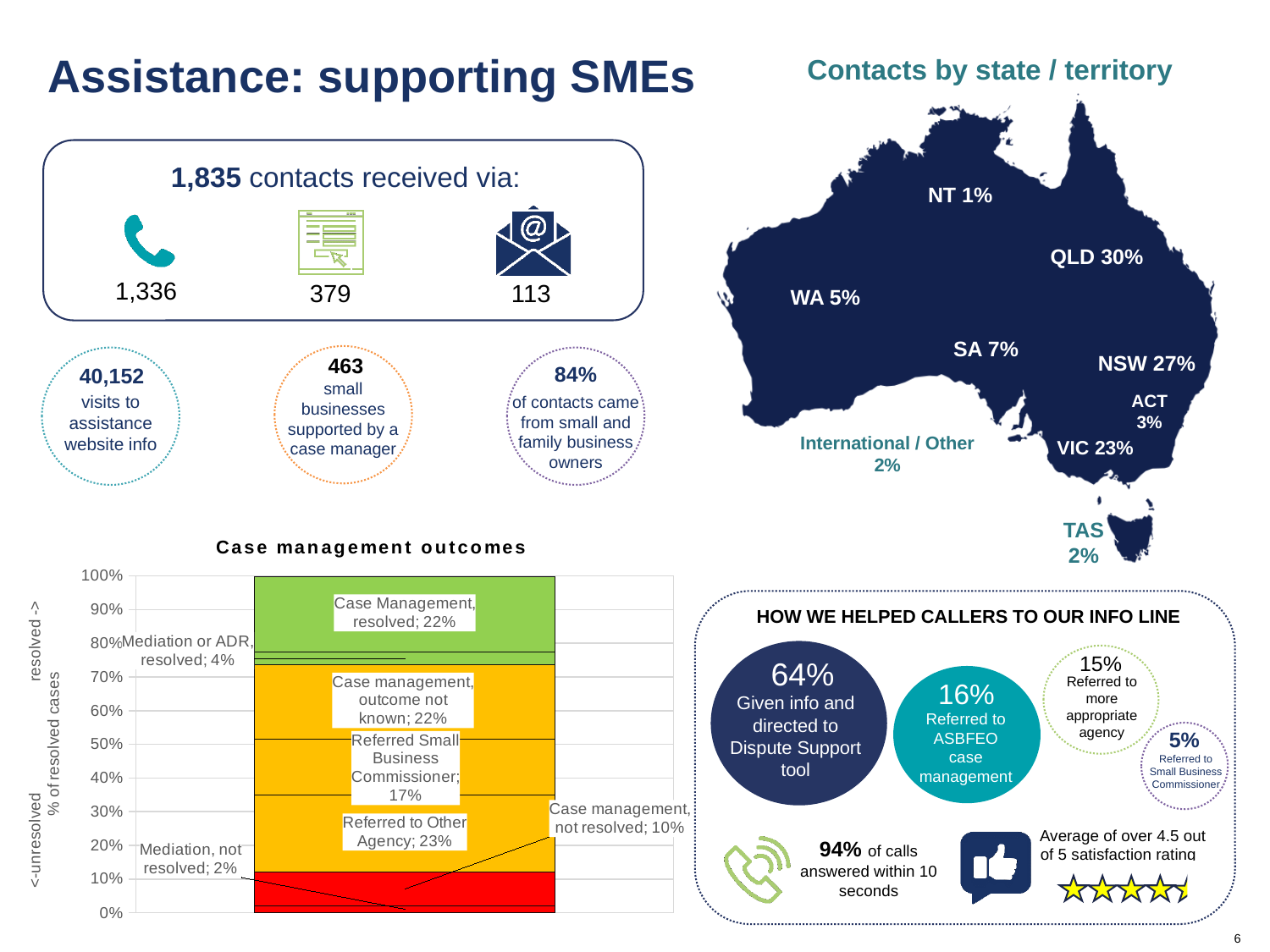
What is the total of all labelled segments in the 'Case management outcomes' stacked bar? 100% In the 'Case management outcomes' chart, what percentage is labelled for 'Referred to Other Agency'? 23% How many labelled segments make up the stacked bar in the 'Case management outcomes' chart? 7 In the 'Case management outcomes' chart, what percentage is labelled for 'Case Management, resolved'? 22% In the 'Case management outcomes' chart, which segment has the largest labelled percentage? Referred to Other Agency In the 'Case management outcomes' chart, what percentage is labelled for 'Referred Small Business Commissioner'? 17% What type of chart is 'Case management outcomes'? Stacked bar chart In the 'Case management outcomes' chart, what percentage is labelled for 'Mediation, not resolved'? 2% In the 'Case management outcomes' chart, what percentage is labelled for 'Case management, not resolved'? 10% In the 'Case management outcomes' chart, which segment has the smallest labelled percentage? Mediation, not resolved In the 'Case management outcomes' chart, which is larger: 'Case management, not resolved' or 'Mediation or ADR, resolved'? Case management, not resolved In the 'Case management outcomes' chart, what is the difference between the 'Referred to Other Agency' and 'Referred Small Business Commissioner' percentages? 6%